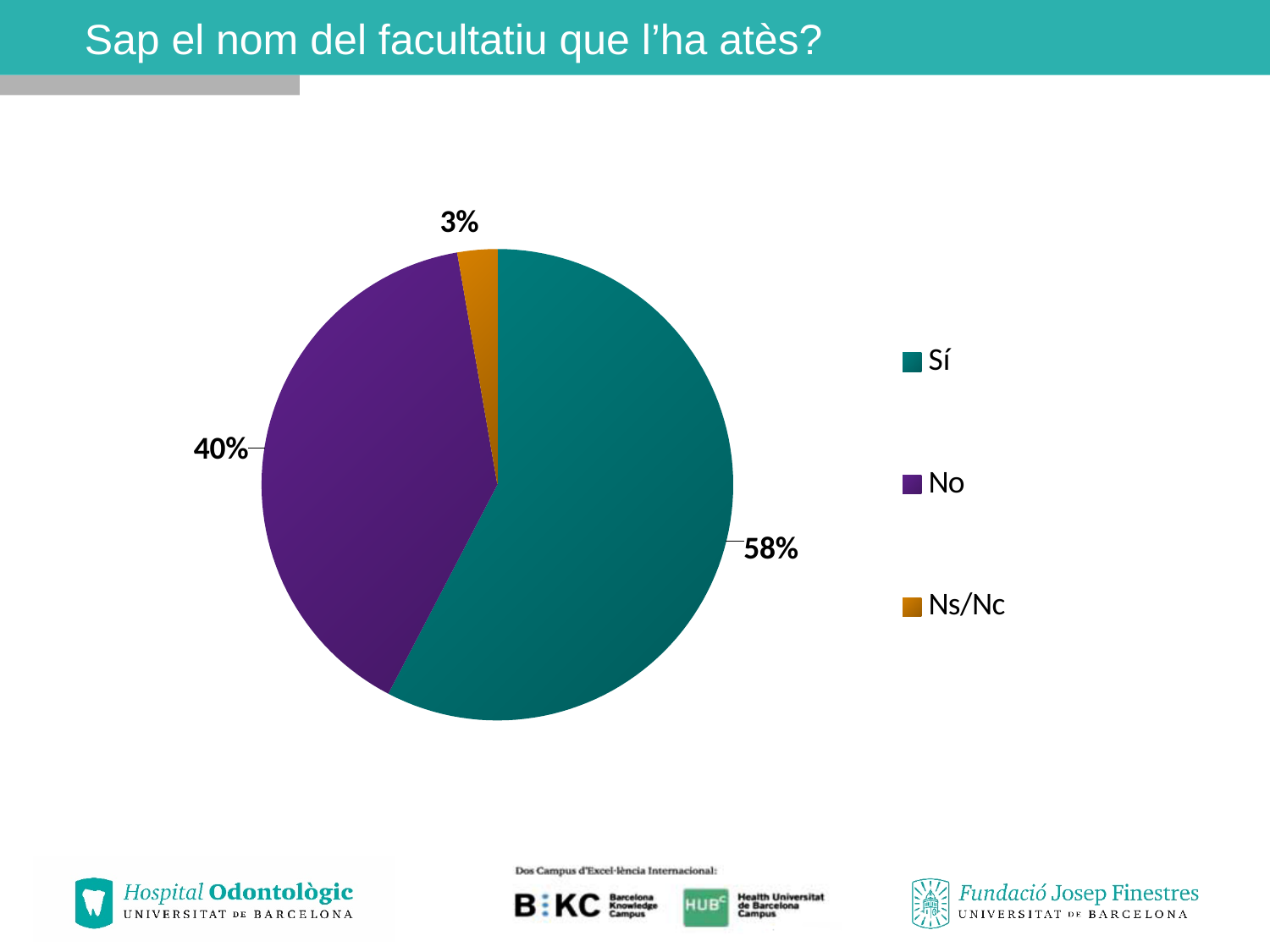
What percentage of respondents answered "Ns/Nc"? 3% What kind of chart is shown on the slide? pie chart What percentage of respondents answered "No"? 40% What is the difference in percentage points between "Sí" and "No"? 18 How many entries does the legend list? 3 Which category has the largest share of the pie? Sí How many categories does the pie chart have? 3 What percentage of respondents answered "Sí"? 58% Which is larger, the share for "No" or the share for "Ns/Nc"? No Which category has the smallest share of the pie? Ns/Nc What is the title of the slide containing the chart? Sap el nom del facultatiu que l'ha atès? What colour is the "No" slice in the pie chart? purple